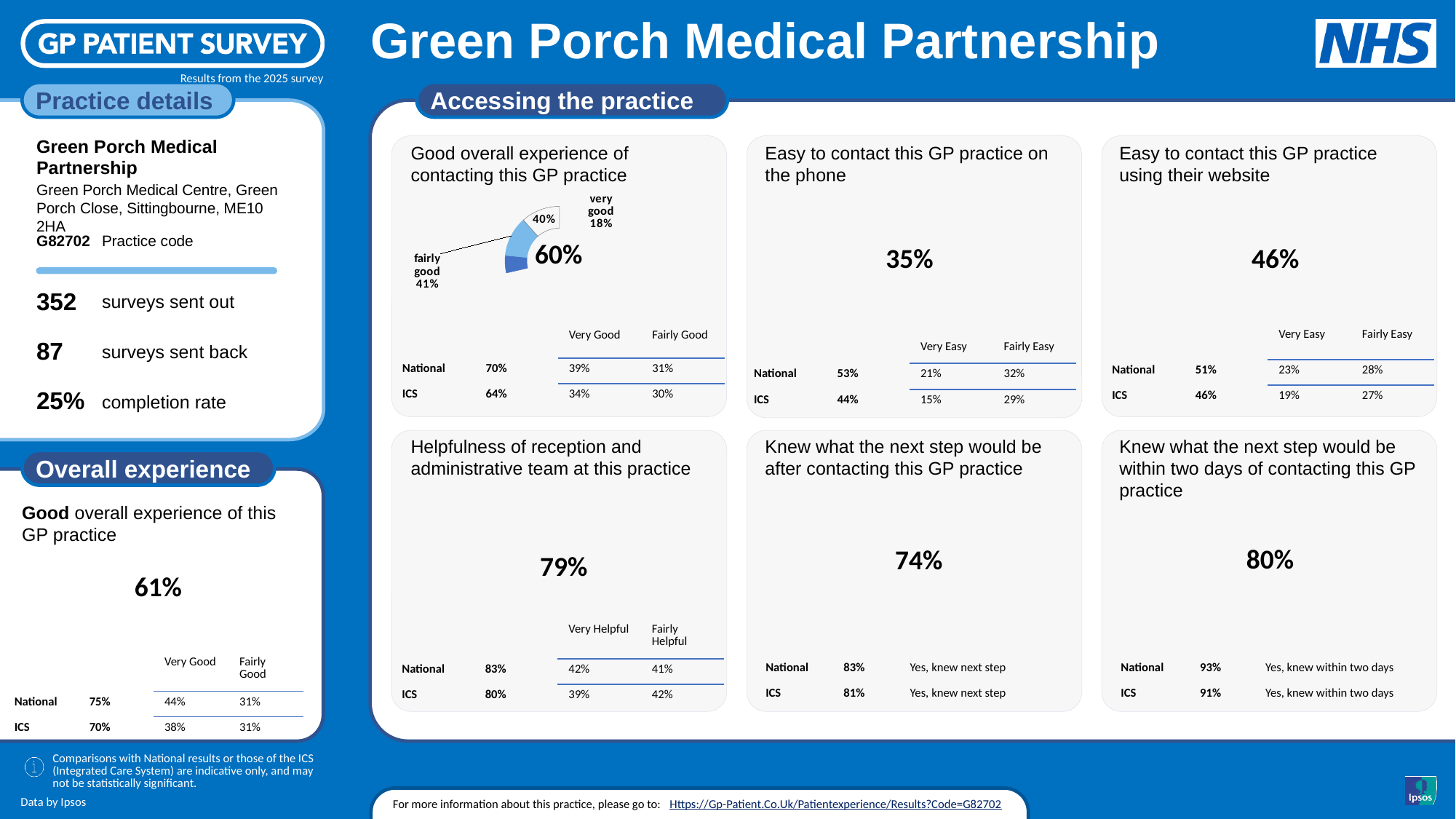
In the 'Good overall experience of contacting this GP practice' chart, which slice is larger, 'very good' or 'fairly good'? fairly good In the 'Good overall experience of contacting this GP practice' chart, what percentage is labelled for 'fairly good'? 41% What headline percentage is printed in the centre of the 'Good overall experience of contacting this GP practice' chart? 60% In the 'Good overall experience of contacting this GP practice' chart, what is the difference between the 'fairly good' and 'very good' percentages? 23% In the 'Good overall experience of contacting this GP practice' chart, which labelled slice is the smallest, 'very good' or 'fairly good'? very good What kind of chart is shown in the 'Good overall experience of contacting this GP practice' panel? pie chart In the 'Good overall experience of contacting this GP practice' chart, what percentage is labelled for 'very good'? 18% What is the title of the panel containing the pie chart on this slide? Good overall experience of contacting this GP practice